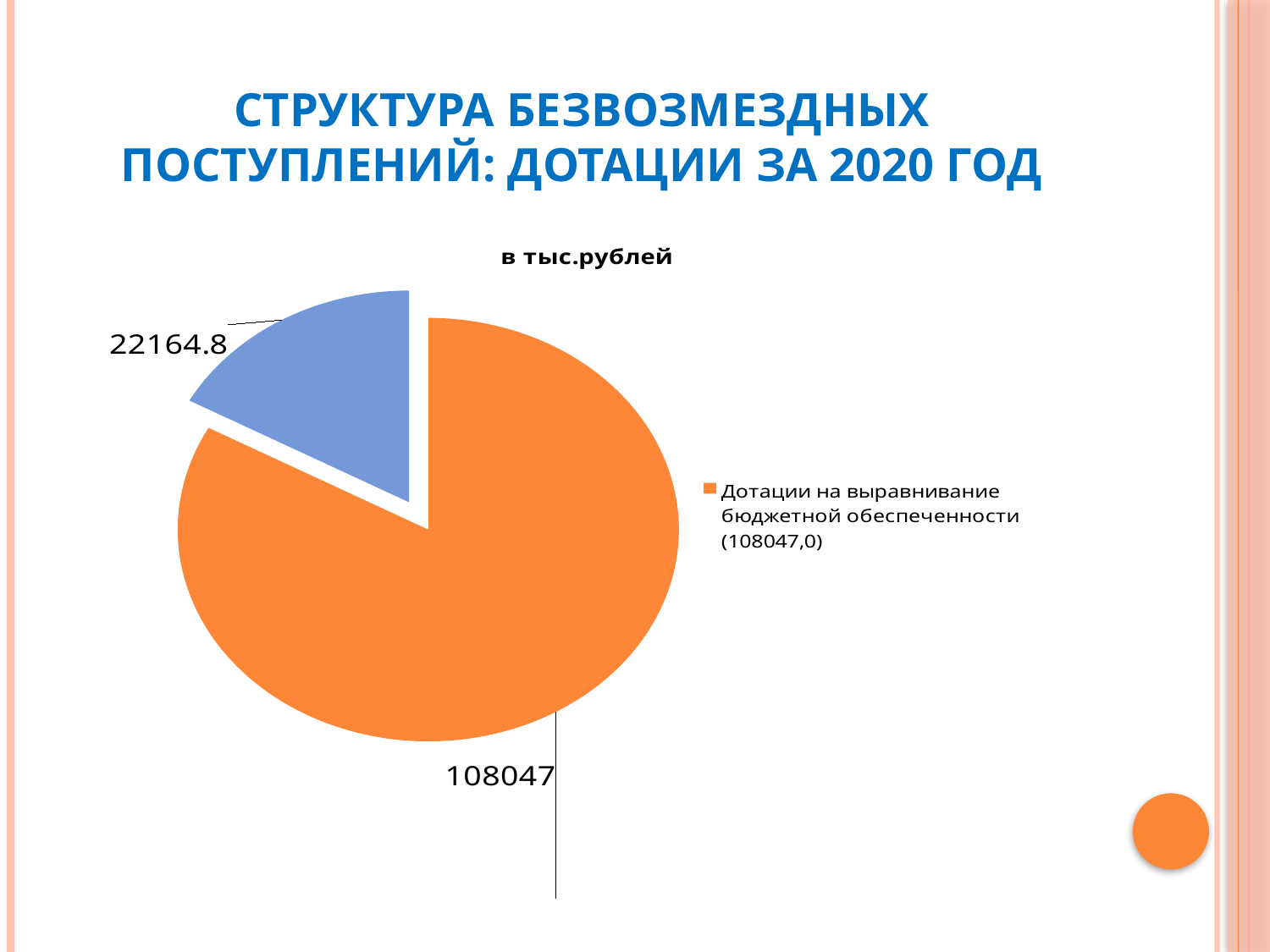
Which is larger: the orange slice or the blue slice? The orange slice What is the total of the two slice values shown on the pie chart? 130211.8 How many slices does the pie chart have? 2 Which slice of the pie chart is the smallest? The blue slice (22164.8) How many entries does the legend list? 1 What is the difference between the orange slice value (108047) and the blue slice value (22164.8)? 85882.2 What value is shown for the slice 'Дотации на выравнивание бюджетной обеспеченности'? 108047 Which slice of the pie chart is the largest? Дотации на выравнивание бюджетной обеспеченности (108047) What kind of chart is shown on the slide? Pie chart What unit is stated in the chart title? в тыс.рублей What value is shown on the blue slice of the pie chart? 22164.8